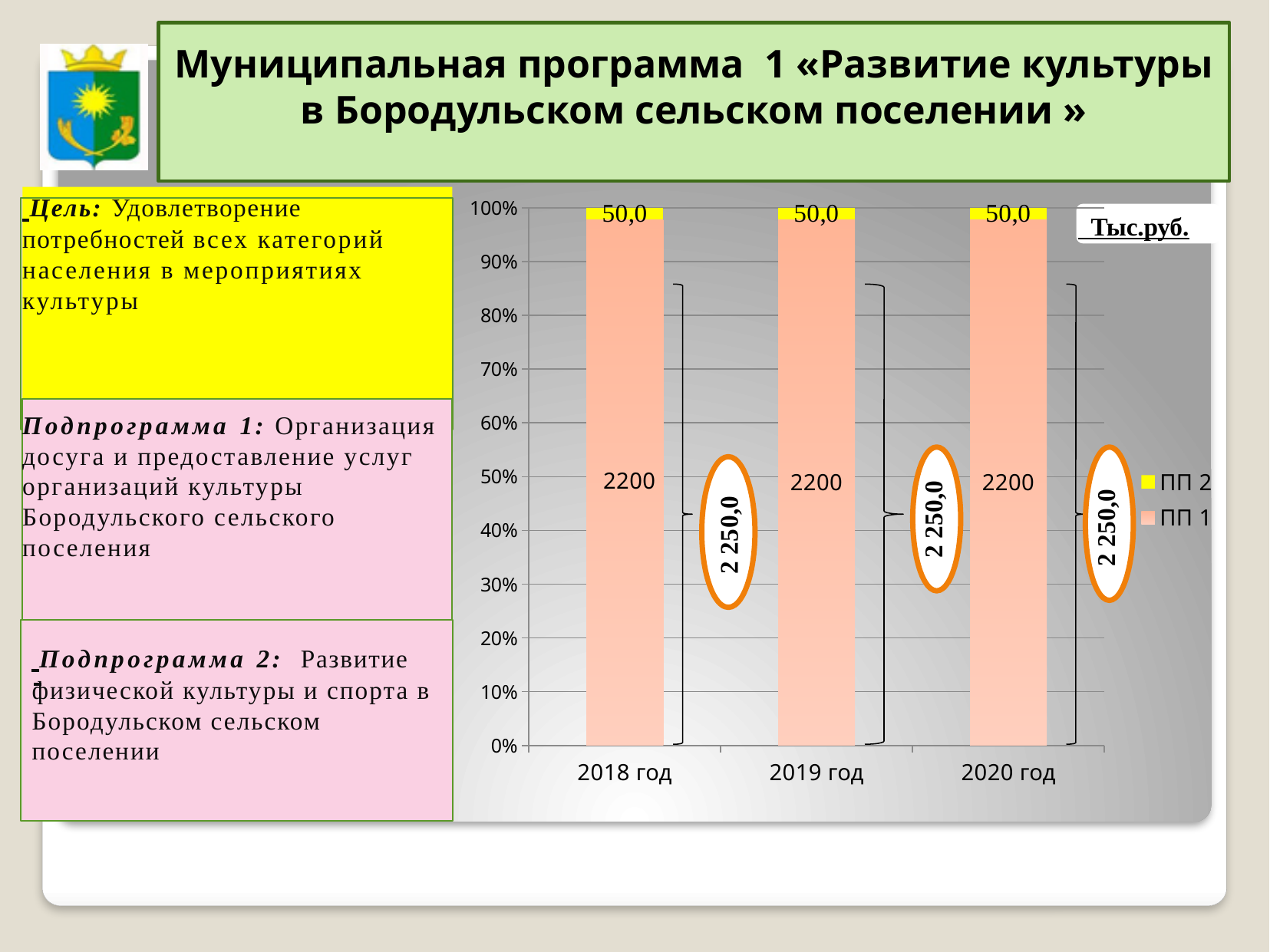
What kind of chart is shown on the slide? bar chart What is the value of ПП 2 for 2019 год? 50,0 Which series is larger for 2018 год, ПП 1 or ПП 2? ПП 1 What is the difference between ПП 1 and ПП 2 for 2020 год? 2150 What is the value of ПП 1 for 2020 год? 2200 How many year categories are shown on the x axis of the chart? 3 What is the value of ПП 1 for 2018 год? 2200 What is the value of ПП 2 for 2020 год? 50,0 How many series does the chart legend list? 2 What is the total of the stacked bar for 2019 год? 2 250,0 What unit label is shown in the top right corner of the chart? Тыс.руб. Does the value of ПП 1 rise, fall or stay the same from 2018 год to 2020 год? stays the same